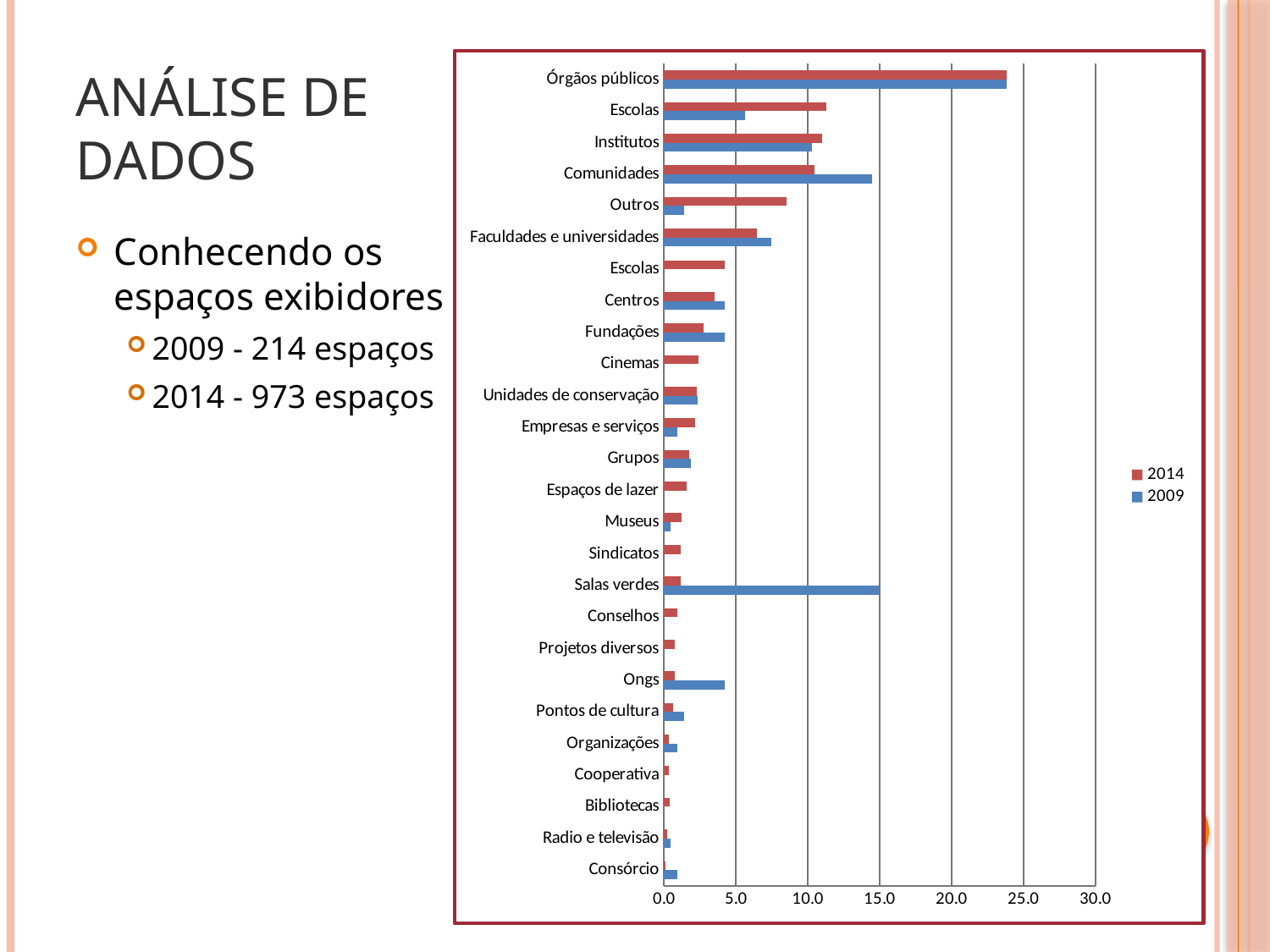
How many series does the chart legend list? 2 Which category has the highest value for the 2009 series? Órgãos públicos For Outros, which series has the larger value, 2014 or 2009? 2014 For Salas verdes, which series has the larger value, 2014 or 2009? 2009 What kind of chart is shown on the slide? bar chart Which category has the highest value for the 2014 series? Órgãos públicos Is the 2014 value for Órgãos públicos greater or less than 20.0? greater Which colour represents the 2009 series in the chart? blue Is the 2014 value for Outros greater or less than 5.0? greater Is the 2009 value for Salas verdes greater or less than 10.0? greater For Ongs, which series has the larger value, 2014 or 2009? 2009